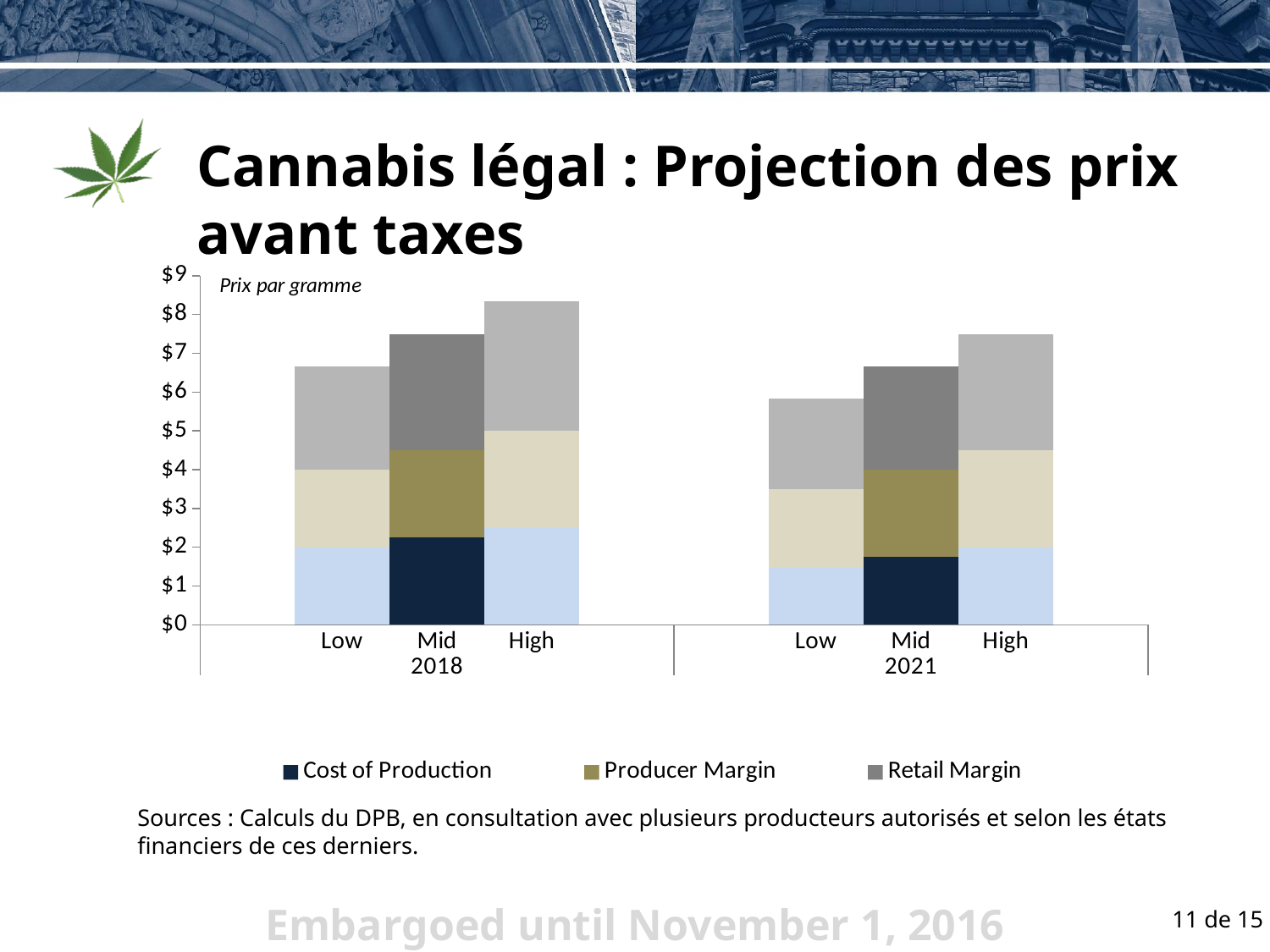
Is the total value for the Mid 2018 bar greater or less than $7? greater Which is larger, the total for High 2018 or the total for High 2021? High 2018 Which bar has the lowest total price per gram? Low 2021 How many bars are plotted in the chart? 6 Is the total value for the High 2018 bar greater or less than $7? greater How many series does the legend list? 3 What unit label is written in italics at the top left of the plot area? Prix par gramme Within 2018, do the total bar heights rise or fall from Low to High? rise Which bar has the highest total price per gram? High 2018 Which series is shown in the darkest colour at the bottom of each bar? Cost of Production Is the total value for the Low 2021 bar greater or less than $7? less What kind of chart is shown on the slide? Stacked bar chart